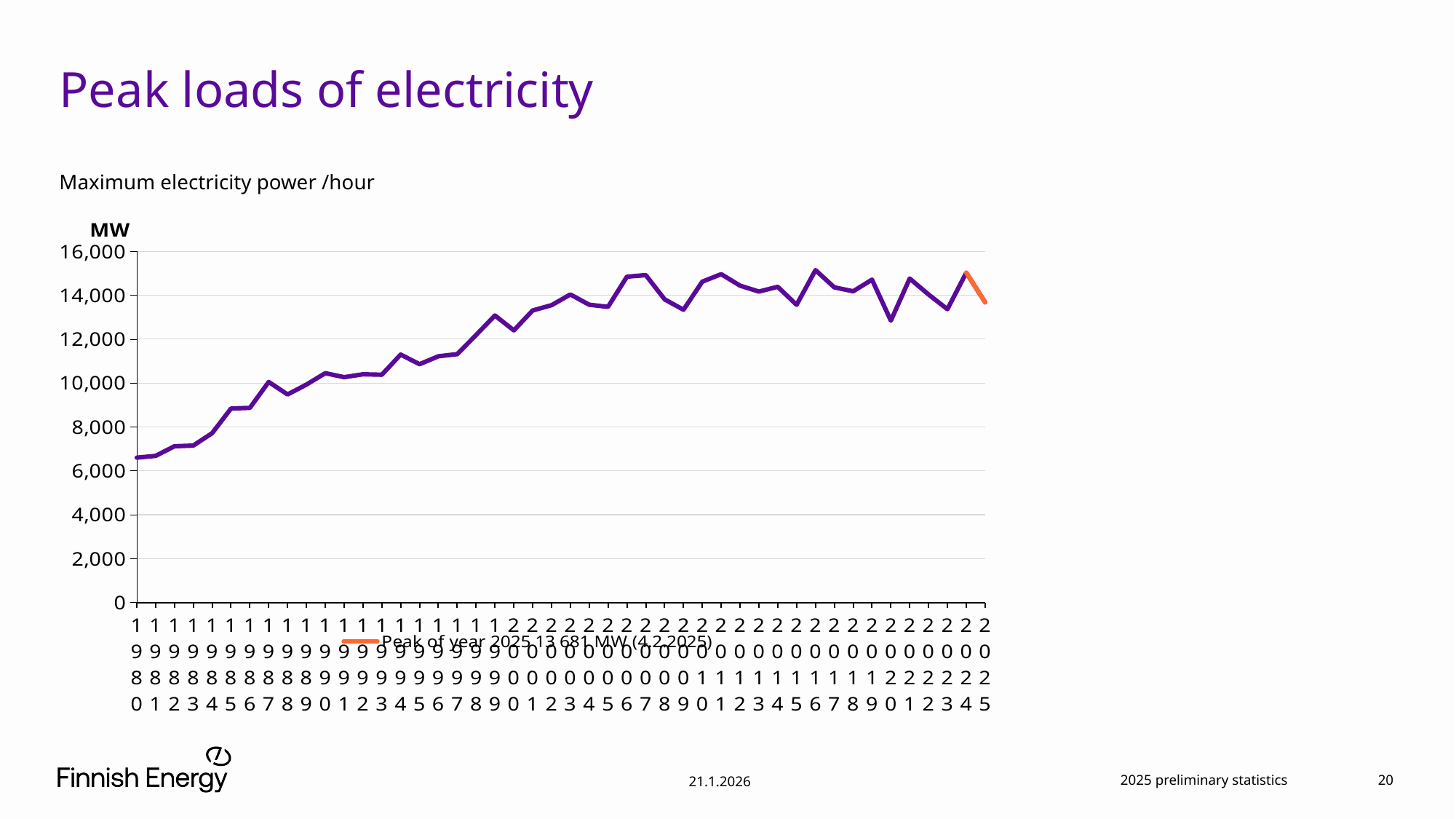
Which is larger, the peak load in 1990 or in 2000? 2000 How many years are plotted on the x axis? 46 Is the value for 2000 greater or less than 12,000? greater What kind of chart is shown on the slide? line chart Which is larger, the peak load in 1980 or in 2025? 2025 According to the legend, what was the peak load of the year 2025? 13 681 MW Is the value for 1980 greater or less than 8,000? less Do the peak loads generally rise or fall from 1980 to 2000? rise Is the value for 2020 greater or less than 14,000? less On what date did the 2025 peak load occur, according to the legend? 4.2.2025 Which year has the lowest peak load? 1980 What unit is shown on the vertical axis? MW